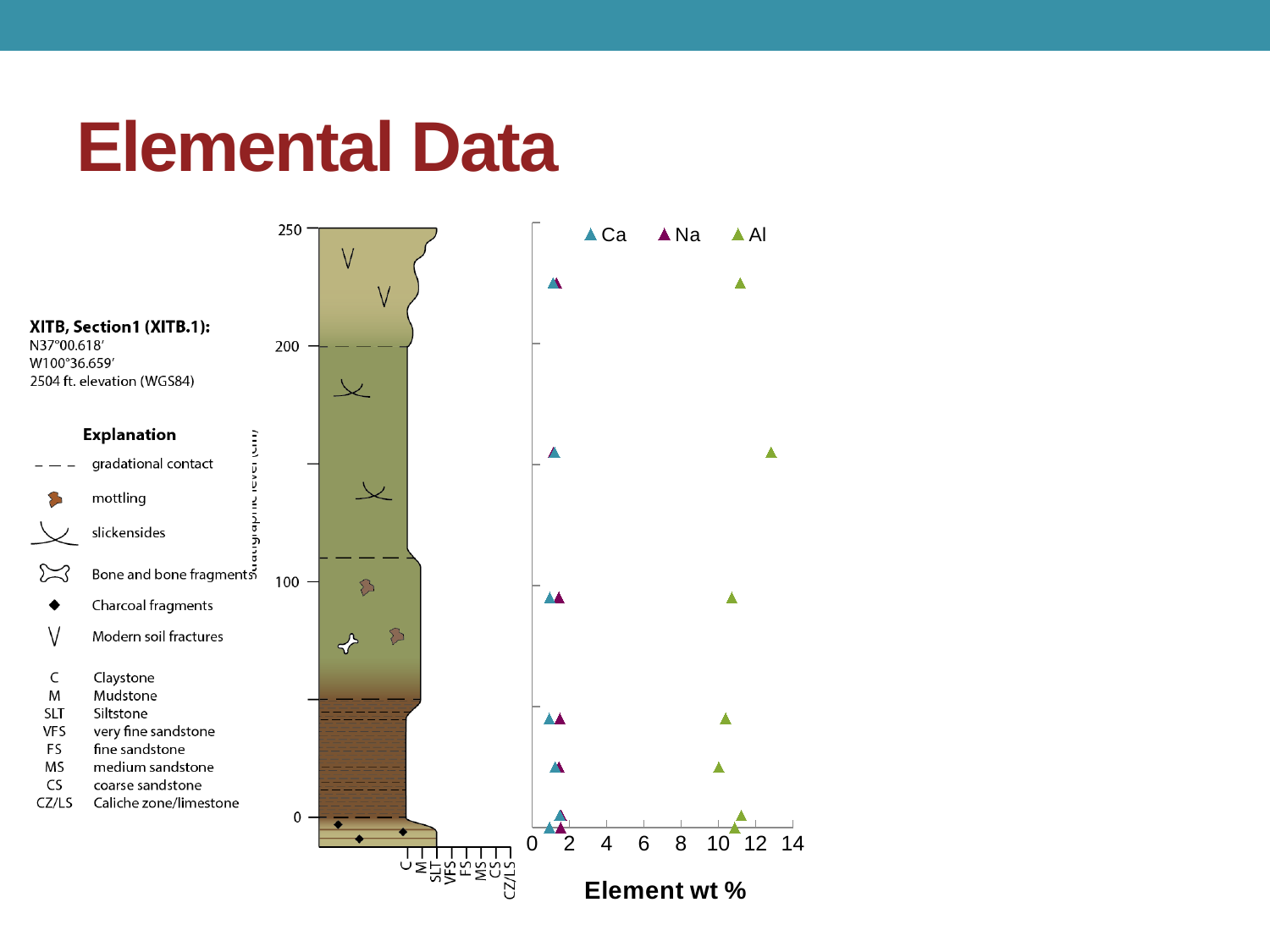
How many series does the legend of the element chart list? 3 What kind of chart is shown on the right side of the slide? scatter chart What is the title of the x axis of the element chart? Element wt % Which elements are listed in the legend of the chart? Ca, Na, Al What is the highest value labelled on the y axis of the element chart? 250 Which series has the highest values in the element chart? Al Is the highest Al value greater or less than 12? greater What is the maximum value shown on the x axis of the element chart? 14 Is the lowest Al value greater or less than 8? greater Which series has larger values, Al or Na? Al Is the highest Ca value greater or less than 2? less How many Al data points are plotted in the element chart? 7